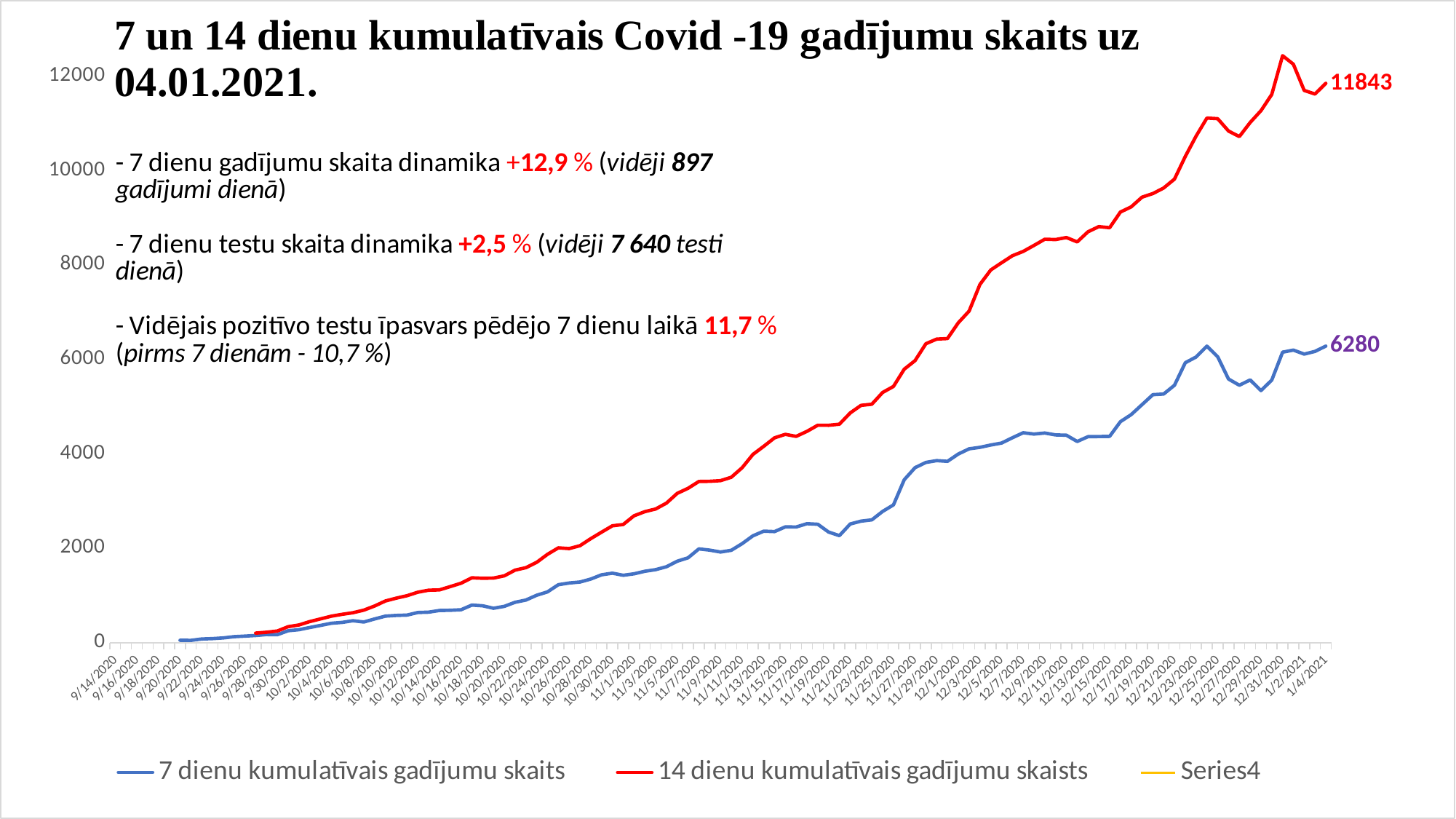
What is the title of the chart? 7 un 14 dienu kumulatīvais Covid -19 gadījumu skaits uz 04.01.2021. Is the value of the 7 dienu series on 11/1/2020 greater or less than 2000? less What is the final labelled value of the '14 dienu kumulatīvais gadījumu skaists' series? 11843 What is the difference between the final labelled values of the 14-day series (11843) and the 7-day series (6280)? 5563 Is the value of the 14 dienu series on 12/31/2020 greater or less than 10000? greater How many series does the legend list? 3 Is the value of the 14 dienu series on 12/15/2020 greater or less than 8000? greater What is the final labelled value of the '7 dienu kumulatīvais gadījumu skaits' series? 6280 Do the values of the 14 dienu series generally rise or fall along the x axis? rise What kind of chart is shown on the slide? line chart What colour is the line for the '14 dienu kumulatīvais gadījumu skaists' series? red Which series has the higher value at the end of the chart, the 7 dienu series or the 14 dienu series? 14 dienu kumulatīvais gadījumu skaists